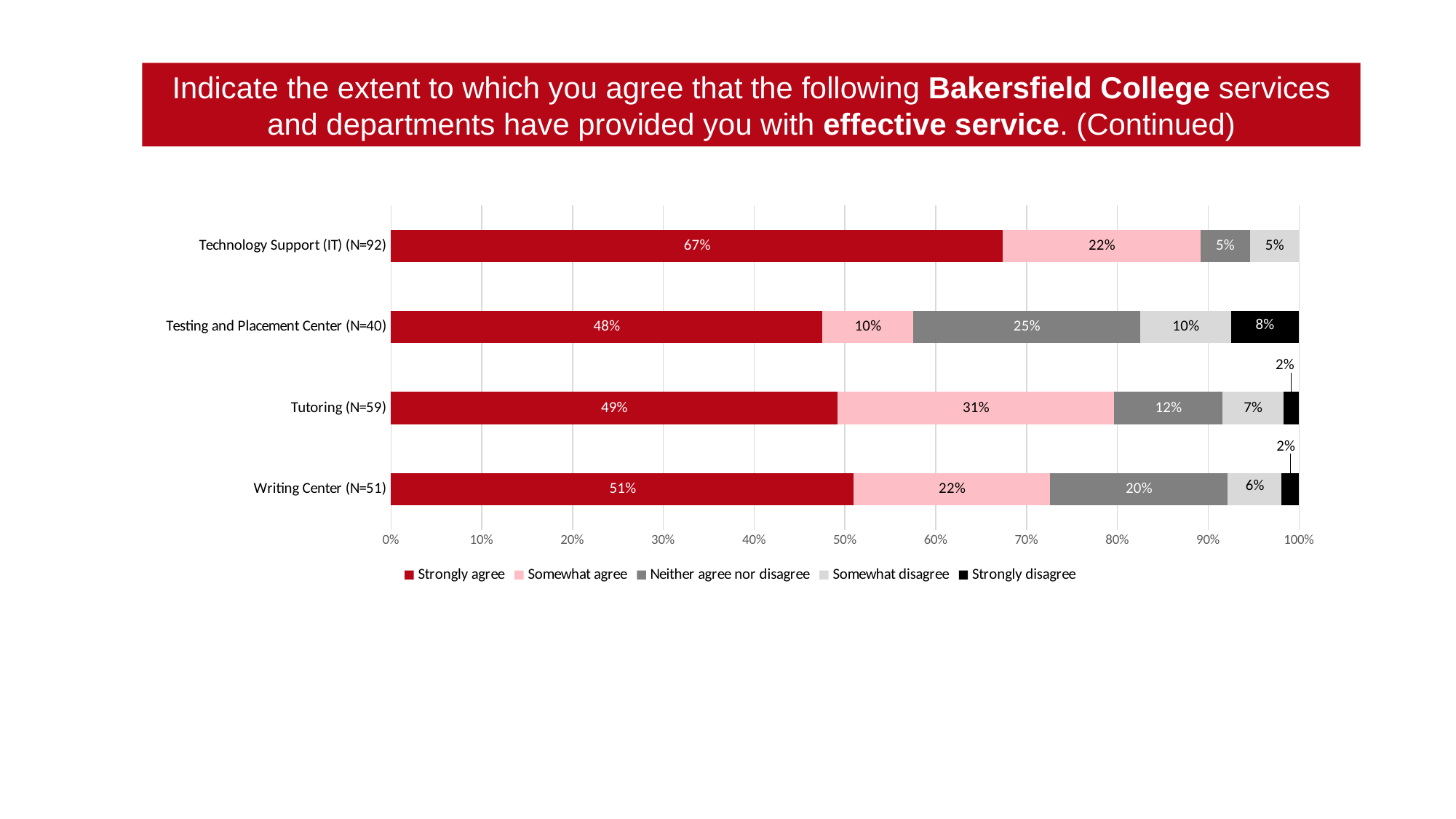
How many response categories does the legend list? 5 What colour represents Strongly disagree in the chart? Black Which service has the lowest Strongly agree percentage? Testing and Placement Center (N=40) Which service has the highest Strongly agree percentage? Technology Support (IT) (N=92) What is the difference between the Strongly agree percentages for Technology Support (IT) and the Writing Center? 16% What percentage of respondents strongly agree that Technology Support (IT) provided effective service? 67% Which has a larger Somewhat agree percentage, Tutoring or the Testing and Placement Center? Tutoring What percentage of respondents neither agree nor disagree for the Testing and Placement Center? 25% What type of chart is shown on the slide? Stacked bar chart What is the Somewhat agree value for Tutoring (N=59)? 31% What is the Strongly disagree value for the Writing Center (N=51)? 2% How many services or departments are shown in the chart? 4